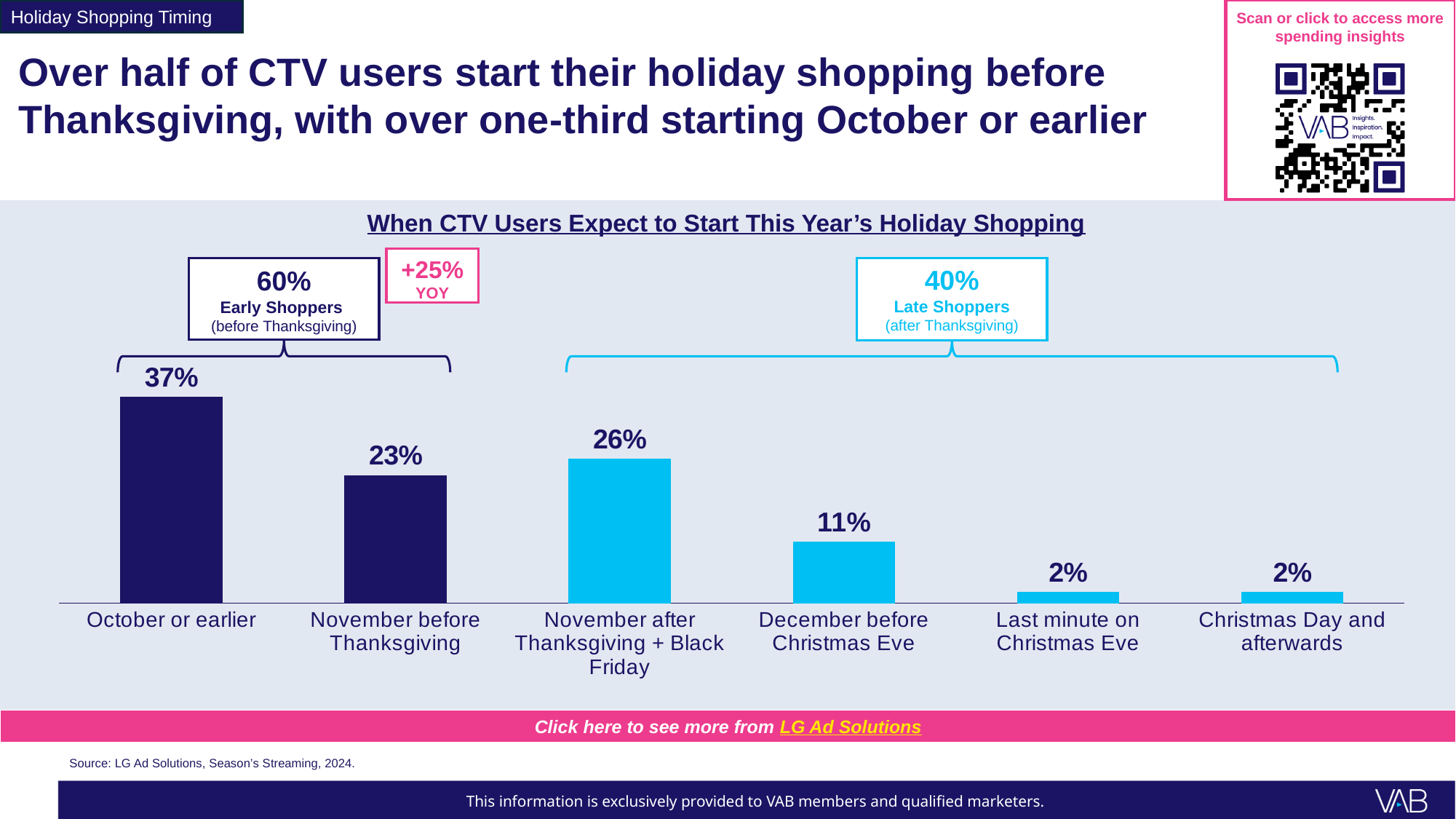
What is the value for December before Christmas Eve? 11% What is the combined share of Early Shoppers (before Thanksgiving) shown on the chart? 60% Which is larger: the value for November before Thanksgiving or the value for December before Christmas Eve? November before Thanksgiving What is the value for November after Thanksgiving + Black Friday? 26% What percentage of CTV users expect to start holiday shopping in October or earlier? 37% What is the value for November before Thanksgiving? 23% What kind of chart is shown on the slide? Bar chart What is the title of the chart? When CTV Users Expect to Start This Year's Holiday Shopping What is the combined share of Late Shoppers (after Thanksgiving) shown on the chart? 40% What is the difference between the values for October or earlier and November after Thanksgiving + Black Friday? 11% How many categories are shown on the x axis? 6 Which category has the highest value? October or earlier